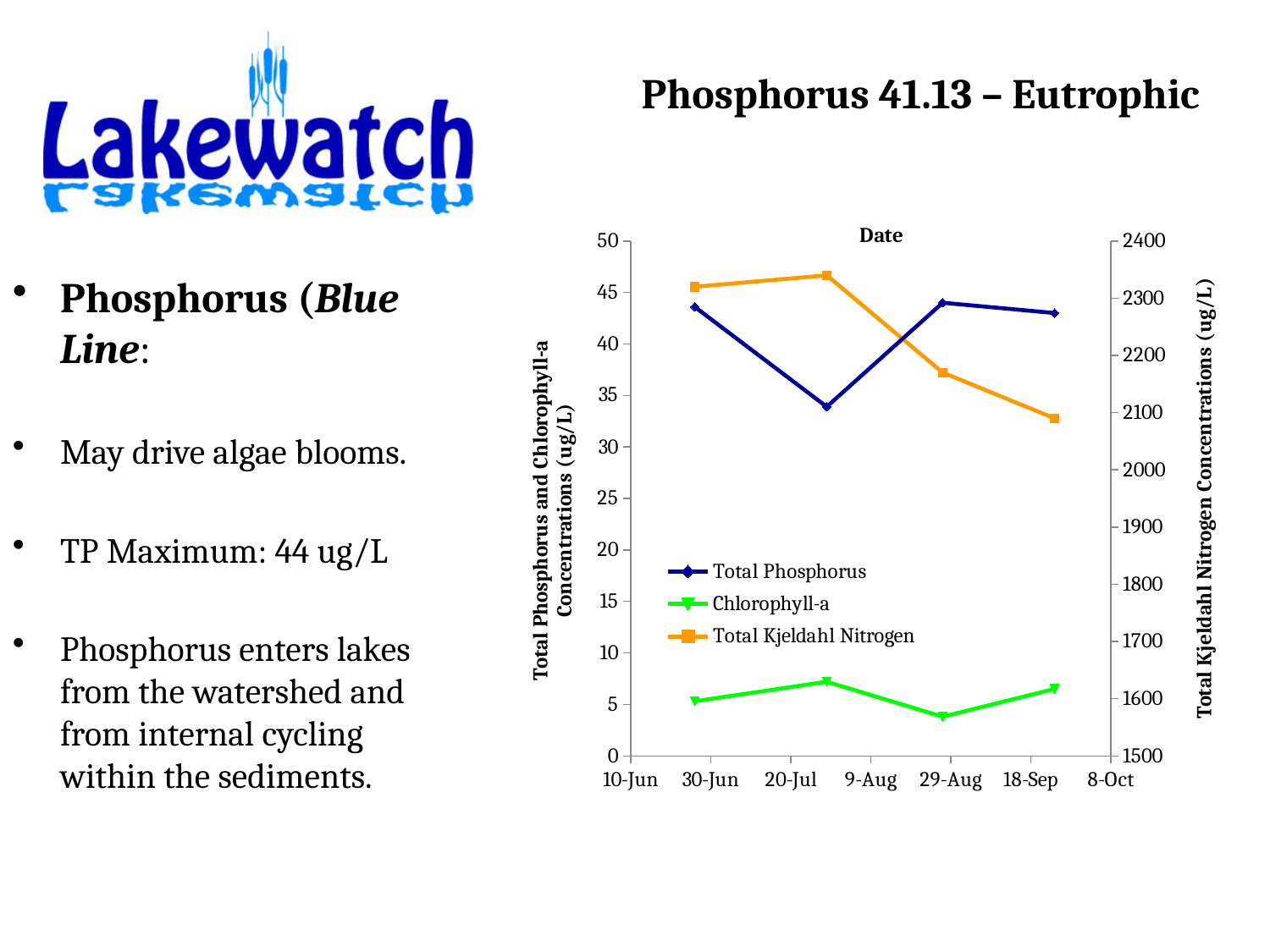
How many series does the chart legend list? 3 Is Total Phosphorus higher at its first point or at its second point? first point How many data points are plotted for the Total Phosphorus series? 4 Of the two series plotted on the left axis, which has the higher values? Total Phosphorus Does Total Kjeldahl Nitrogen rise or fall from its first point to its last point? fall Is the value of Total Kjeldahl Nitrogen at its last point (late September) greater or less than 2200? less What kind of chart is shown on the slide? line chart Is the value of Total Phosphorus at its first point (late June) greater or less than 40? greater Is the value of Total Phosphorus at its second point (late July) greater or less than 40? less What is the label of the right-hand vertical axis? Total Kjeldahl Nitrogen Concentrations (ug/L) Which series has the lowest values on the left axis throughout the chart? Chlorophyll-a